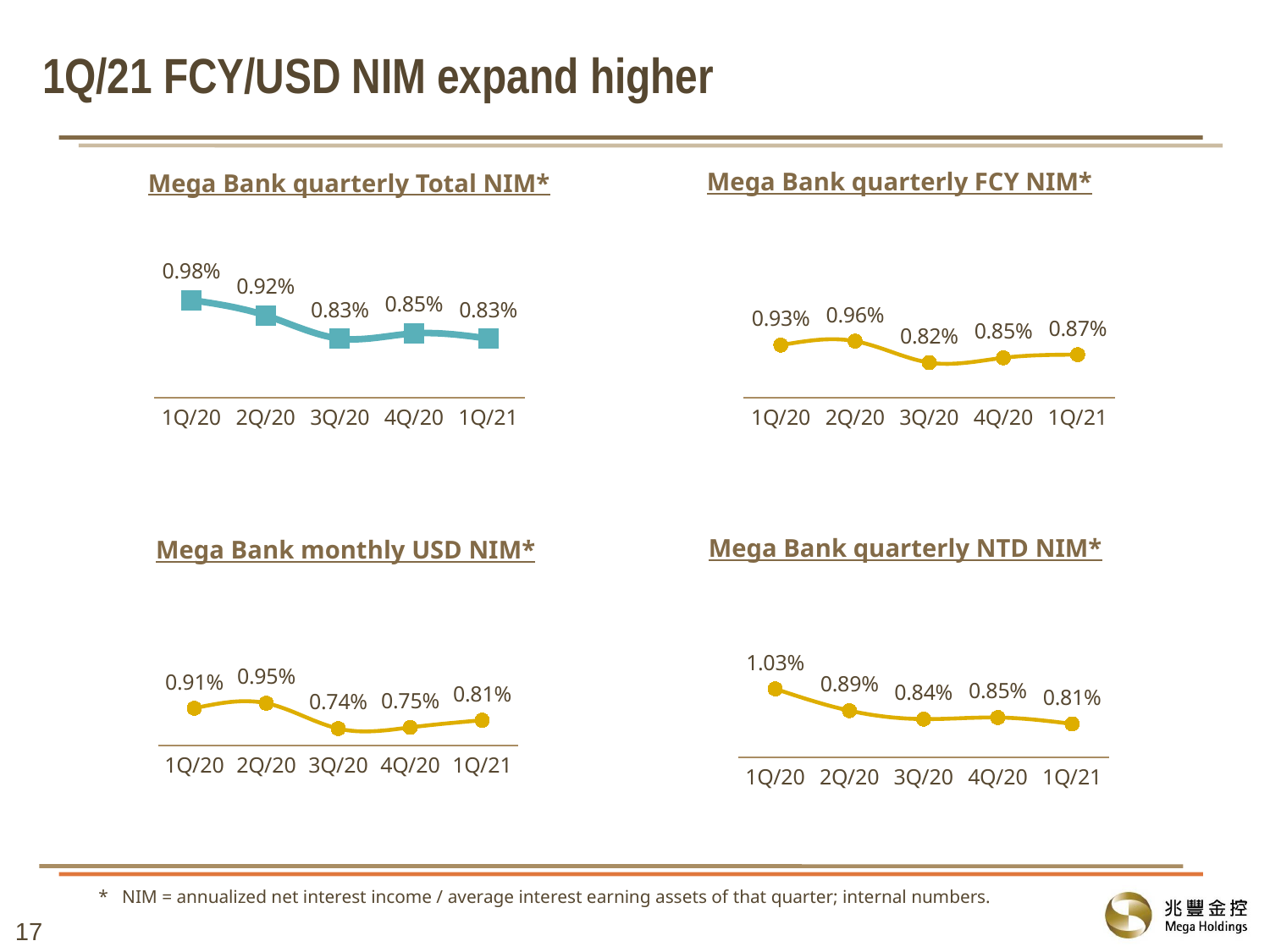
In the Mega Bank quarterly Total NIM chart, what is the value for 1Q/20? 0.98% In the Mega Bank quarterly FCY NIM chart, which quarter has the lowest value? 3Q/20 In the Mega Bank quarterly FCY NIM chart, what is the value for 1Q/21? 0.87% In the Mega Bank quarterly Total NIM chart, do the values rise or fall from 1Q/20 to 3Q/20? Fall How many charts are shown on the slide? 4 In the Mega Bank monthly USD NIM chart, which is larger, the value for 2Q/20 or the value for 1Q/21? 2Q/20 In the Mega Bank quarterly NTD NIM chart, what is the difference between the 1Q/20 value and the 1Q/21 value? 0.22% In the Mega Bank monthly USD NIM chart, what is the difference between the 1Q/21 value and the 4Q/20 value? 0.06% In the Mega Bank monthly USD NIM chart, what is the value for 3Q/20? 0.74% What kind of chart is the Mega Bank quarterly FCY NIM chart? Line chart In the Mega Bank quarterly NTD NIM chart, which quarter has the highest value? 1Q/20 How many data points are plotted in the Mega Bank quarterly Total NIM chart? 5